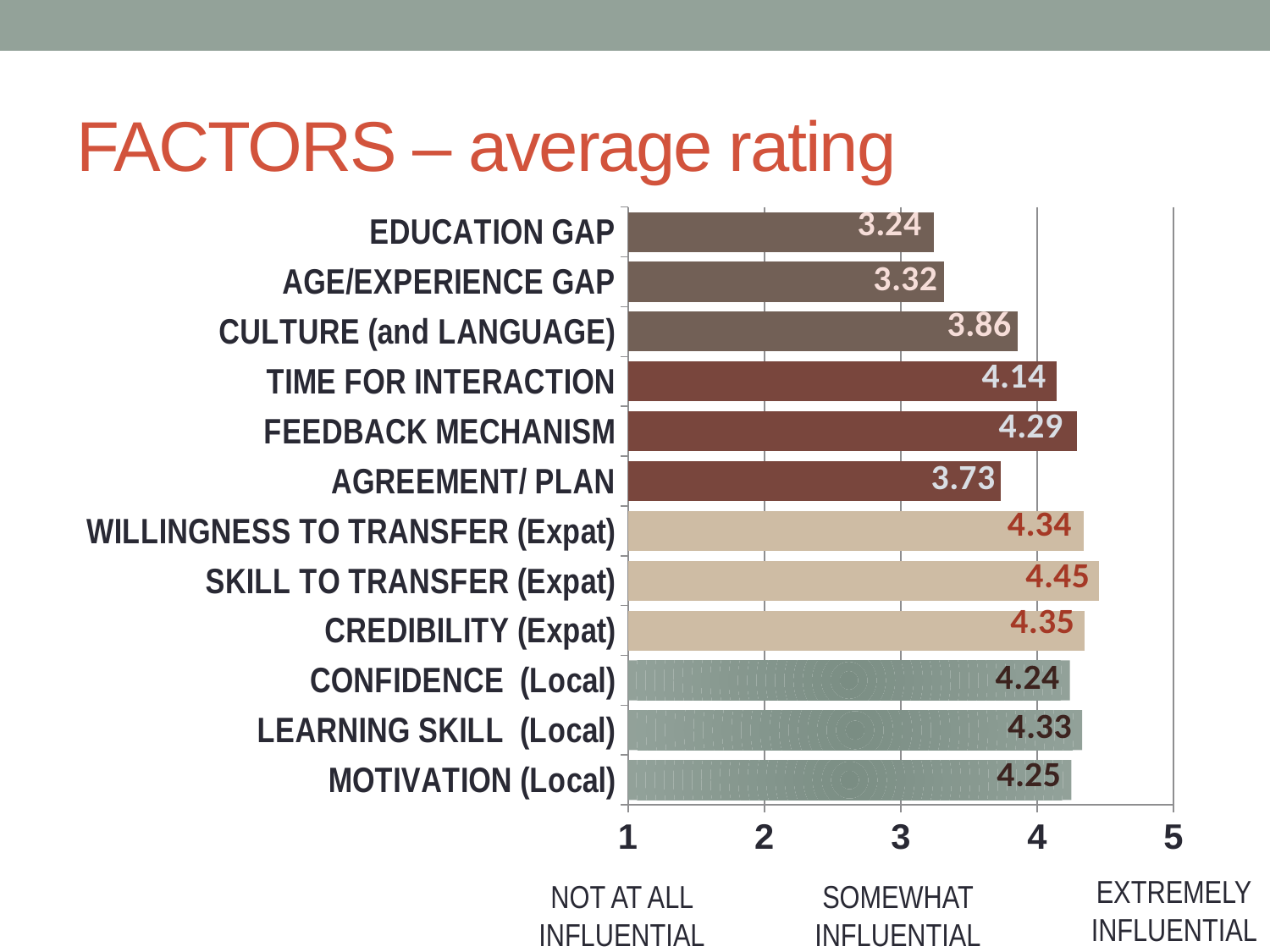
What is the average rating for FEEDBACK MECHANISM? 4.29 What is the average rating for EDUCATION GAP? 3.24 What kind of chart is shown on the slide? bar chart Which factor has the lowest average rating? EDUCATION GAP How many factors are shown in the chart? 12 What is the average rating for MOTIVATION (Local)? 4.25 What label appears under the value 5 on the axis? EXTREMELY INFLUENTIAL Which factor has the highest average rating? SKILL TO TRANSFER (Expat) What is the difference between the ratings for SKILL TO TRANSFER (Expat) and EDUCATION GAP? 1.21 Is the value for CULTURE (and LANGUAGE) greater or less than 4? less What is the title of the slide? FACTORS – average rating Which has a higher average rating, TIME FOR INTERACTION or AGREEMENT/ PLAN? TIME FOR INTERACTION